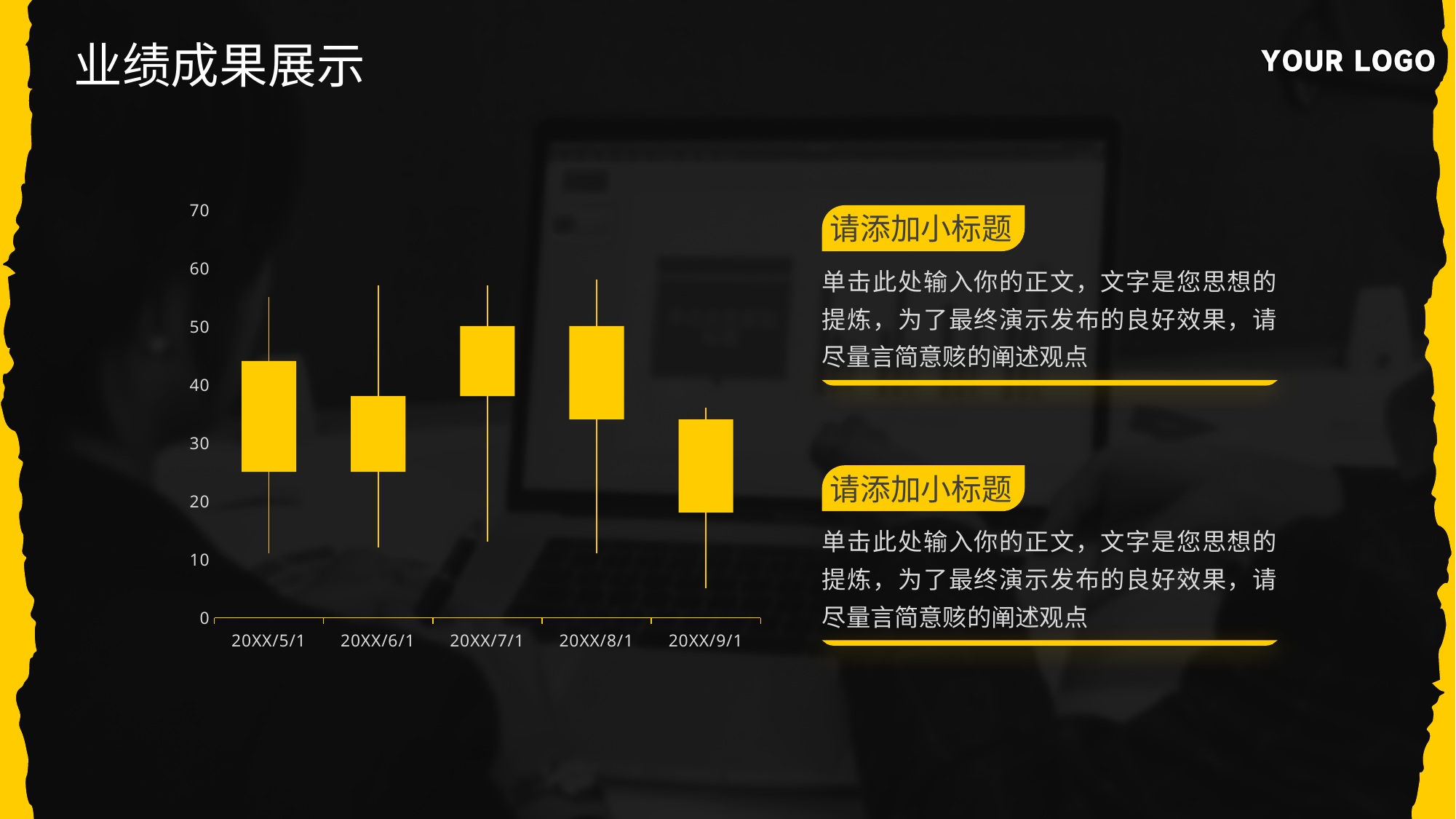
Is the top of the box for 20XX/7/1 greater or less than 40? greater Which date's lower wick reaches the lowest value on the chart? 20XX/9/1 Which date has the lowest bottom of its box (candle body)? 20XX/9/1 How many dates are plotted along the x axis of the chart? 5 What is the title of the slide containing the chart? 业绩成果展示 Is the highest point of the wick for 20XX/5/1 greater or less than 50? greater What is the label of the first category on the x axis? 20XX/5/1 Is the lowest point of the wick for 20XX/9/1 greater or less than 10? less Which date has the lowest top of its box (candle body)? 20XX/9/1 What kind of chart is shown on the slide? Stock (candlestick) chart Is the top of the box for 20XX/7/1 higher or lower than the top of the box for 20XX/6/1? higher